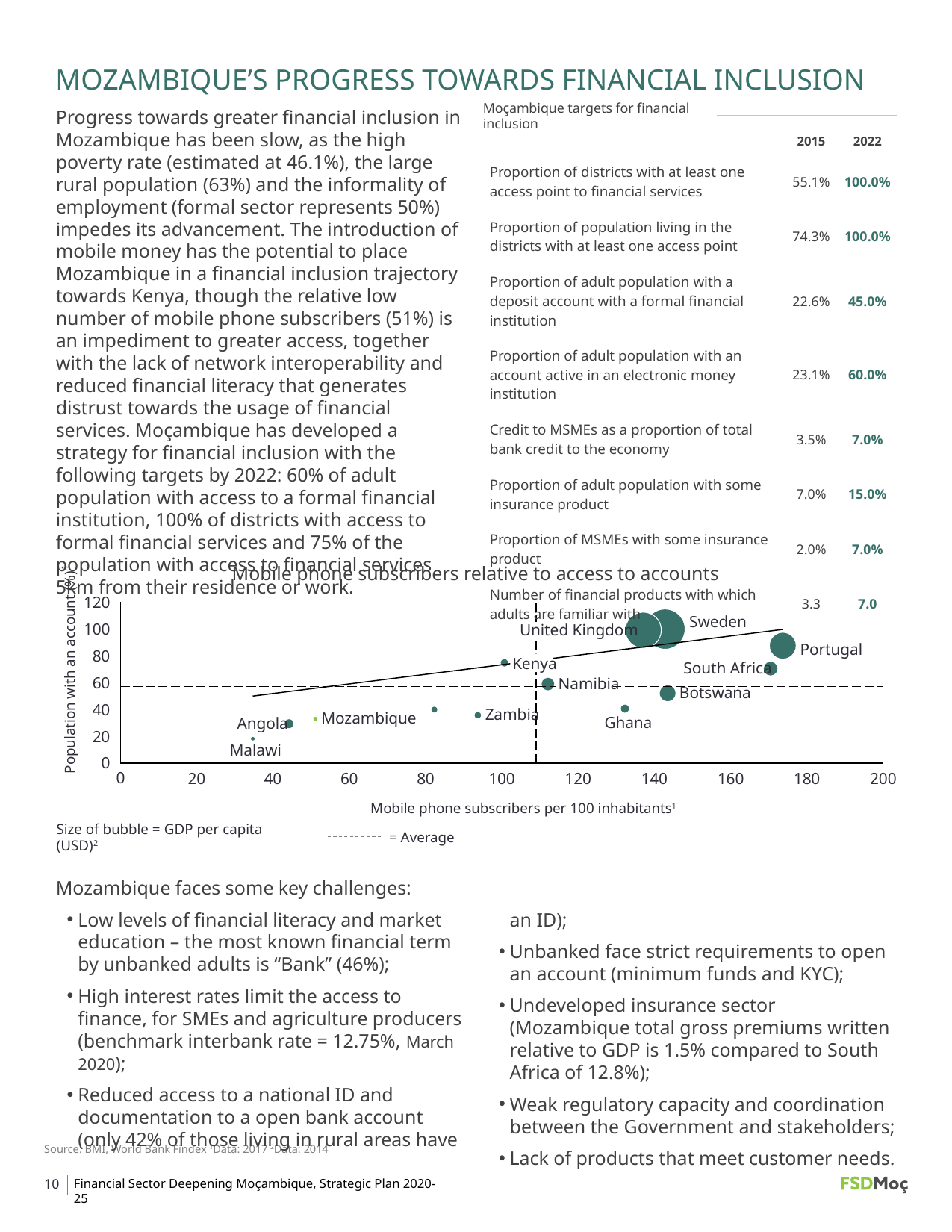
In the bubble chart, how many countries are labelled? 12 In the bubble chart, is the number of mobile phone subscribers per 100 inhabitants for Mozambique greater or less than 40? greater In the bubble chart, is the number of mobile phone subscribers per 100 inhabitants for Portugal greater or less than 160? greater In the bubble chart, what does the size of each bubble represent? GDP per capita (USD) In the bubble chart, which has more mobile phone subscribers per 100 inhabitants, Portugal or Mozambique? Portugal In the bubble chart, which country has the lowest population with an account (%)? Malawi In the bubble chart, does the population with an account generally rise or fall as mobile phone subscribers per 100 inhabitants increase? rise In the bubble chart, is the population with an account for Kenya greater or less than 60? greater What kind of chart is shown under the title 'Mobile phone subscribers relative to access to accounts'? Bubble chart In the bubble chart, which has a higher population with an account, Kenya or Zambia? Kenya